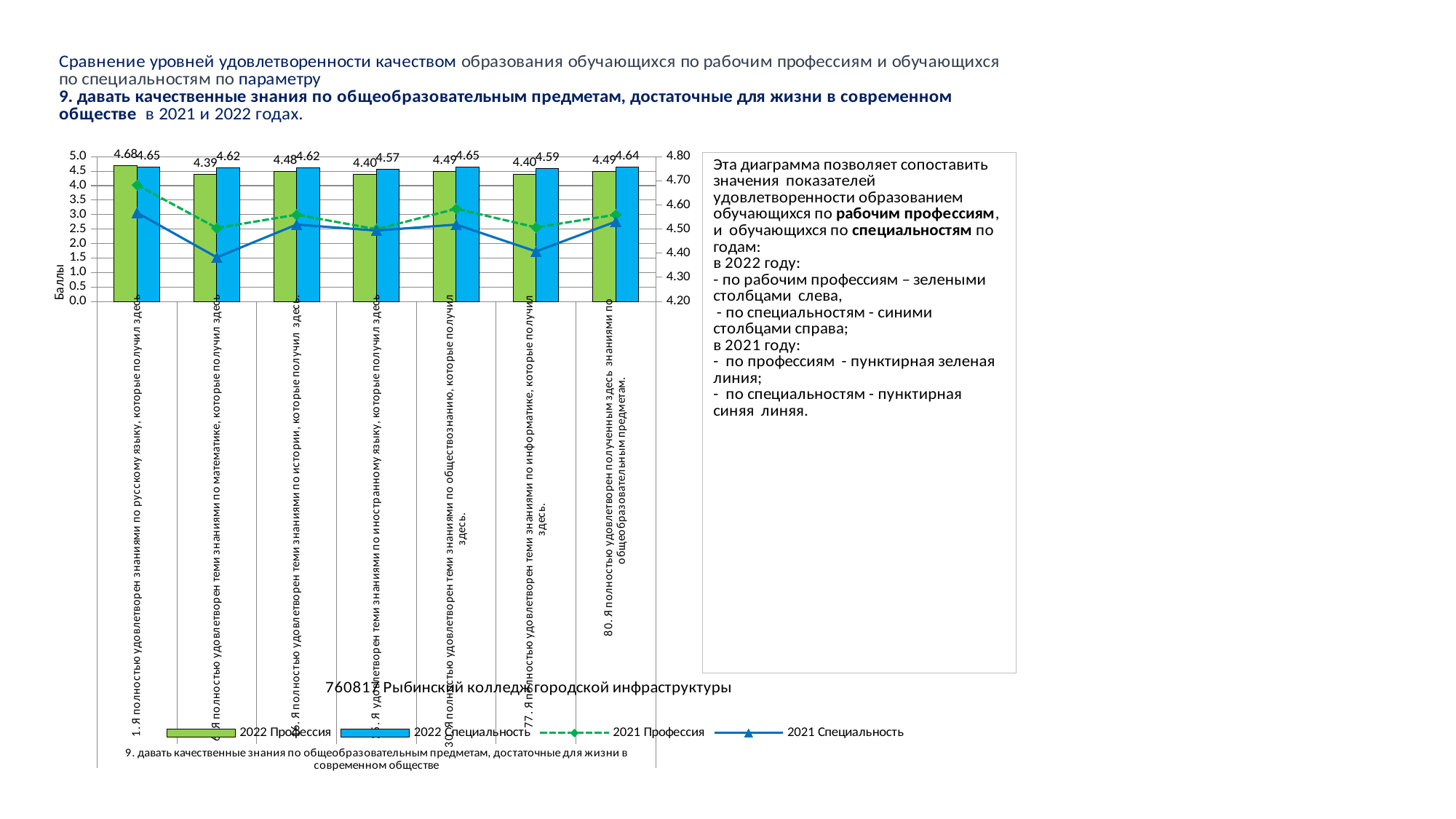
Which category has the highest 2022 Профессия bar? 1. Я полностью удовлетворен знаниями по русскому языку, которые получил здесь Which category has the lowest 2022 Профессия bar? Я полностью удовлетворен теми знаниями по математике, которые получил здесь What is the value of the 2022 Профессия bar for the category about знания по математике? 4.39 How many categories are shown on the x axis of the chart? 7 What is the value of the 2022 Профессия bar for the category about знания по русскому языку? 4.68 How many series does the chart legend list? 4 What is the value of the 2022 Специальность bar for the category about знания по иностранному языку? 4.57 For the category about знания по русскому языку, which is larger: the 2022 Профессия bar or the 2022 Специальность bar? 2022 Профессия Is the 2021 Специальность value for the category about знания по информатике greater or less than 4.50 on the right axis? less Which series is drawn as a green dashed line in the chart? 2021 Профессия What is the difference between the 2022 Специальность and 2022 Профессия values for the category about знания по математике? 0.23 Is the 2021 Профессия value for the category about знания по русскому языку greater or less than 4.60 on the right axis? greater